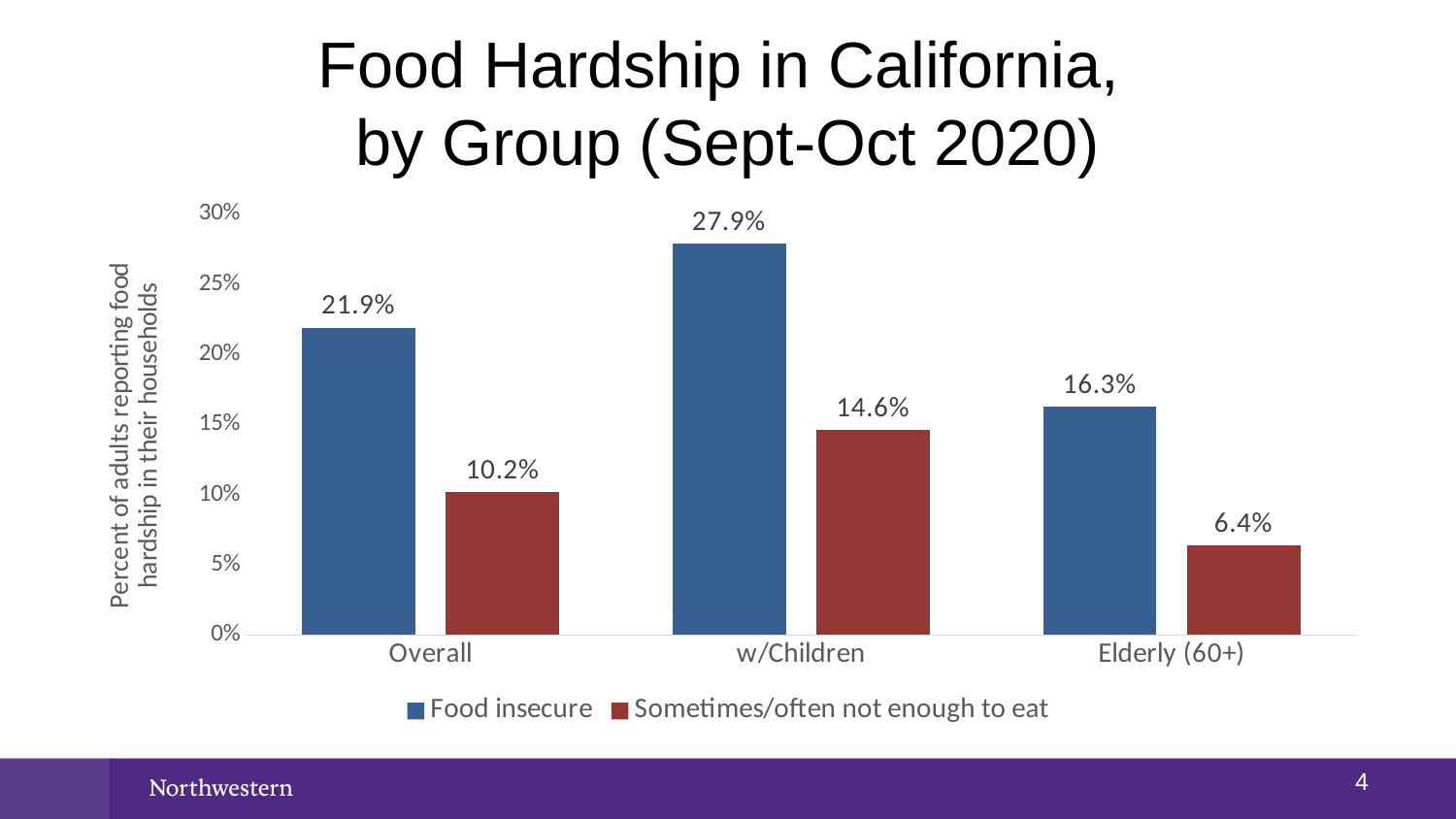
What is the difference between the Food insecure and Sometimes/often not enough to eat values for the w/Children group? 13.3% What is the y-axis label of the chart? Percent of adults reporting food hardship in their households Is the Food insecure value for Elderly (60+) greater or less than 20%? less How many series does the legend list? 2 What is the Food insecure value for the Overall group? 21.9% Which group has the lowest Sometimes/often not enough to eat value? Elderly (60+) What percentage of adults in the w/Children group are food insecure? 27.9% How many groups are shown on the x axis? 3 What kind of chart is shown on the slide? Bar chart What is the value for Sometimes/often not enough to eat in the Elderly (60+) group? 6.4% Which is larger: the Food insecure value for Elderly (60+) or the Sometimes/often not enough to eat value for w/Children? Food insecure for Elderly (60+) Which group has the highest Food insecure value? w/Children